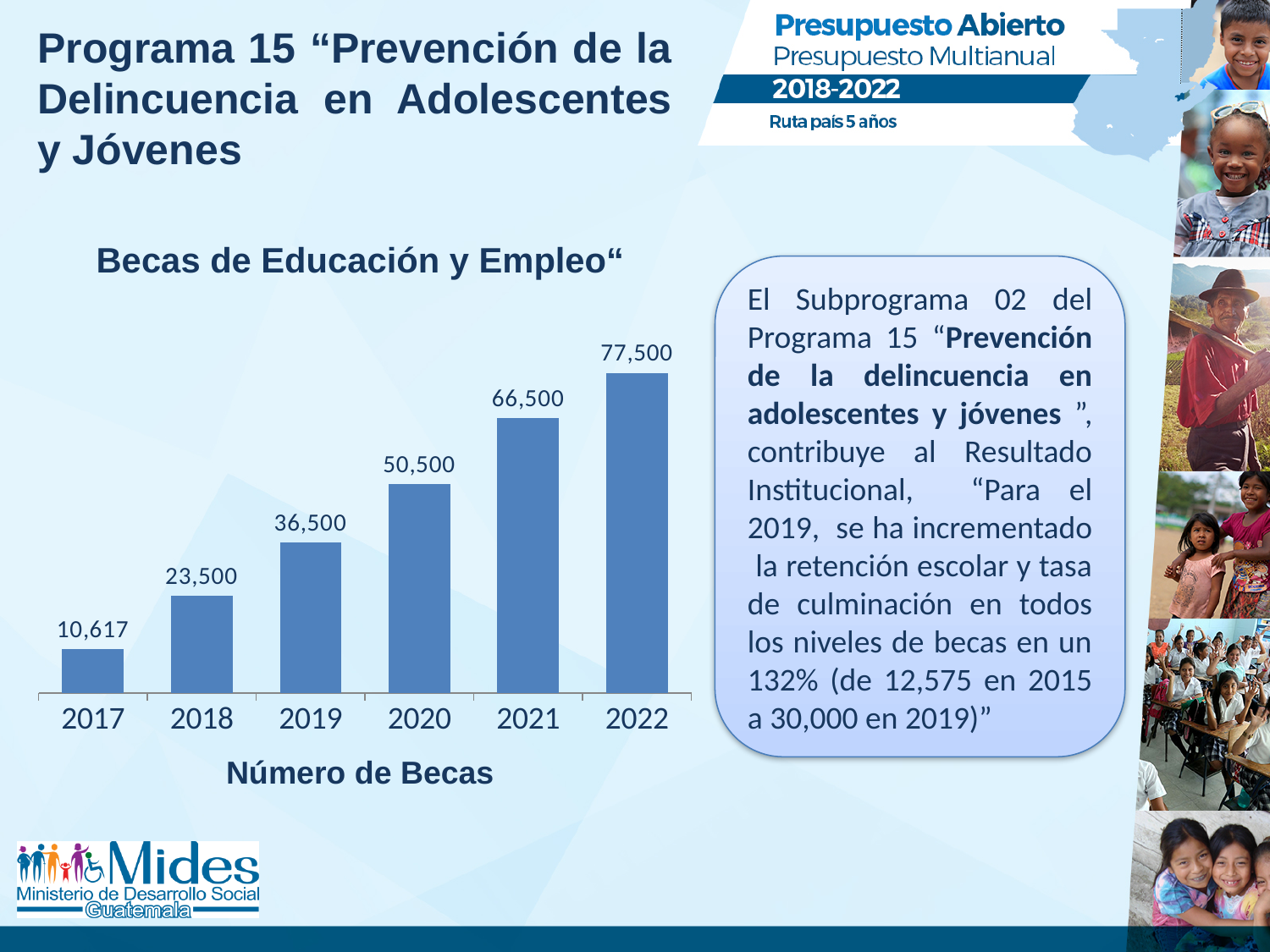
What is the difference between the number of becas in 2019 and in 2018? 13,000 What is the difference between the number of becas in 2022 and in 2021? 11,000 Which year has the lowest number of becas? 2017 What is the number of becas shown for 2022? 77,500 What is the label shown below the x axis of the chart? Número de Becas Which year has the highest number of becas? 2022 How many years are shown on the x axis of the chart? 6 Which year has more becas, 2019 or 2020? 2020 Do the number of becas rise or fall from 2017 to 2022? Rise What is the number of becas shown for 2020? 50,500 What is the number of becas shown for 2017? 10,617 What kind of chart is used to show the number of becas? Bar chart